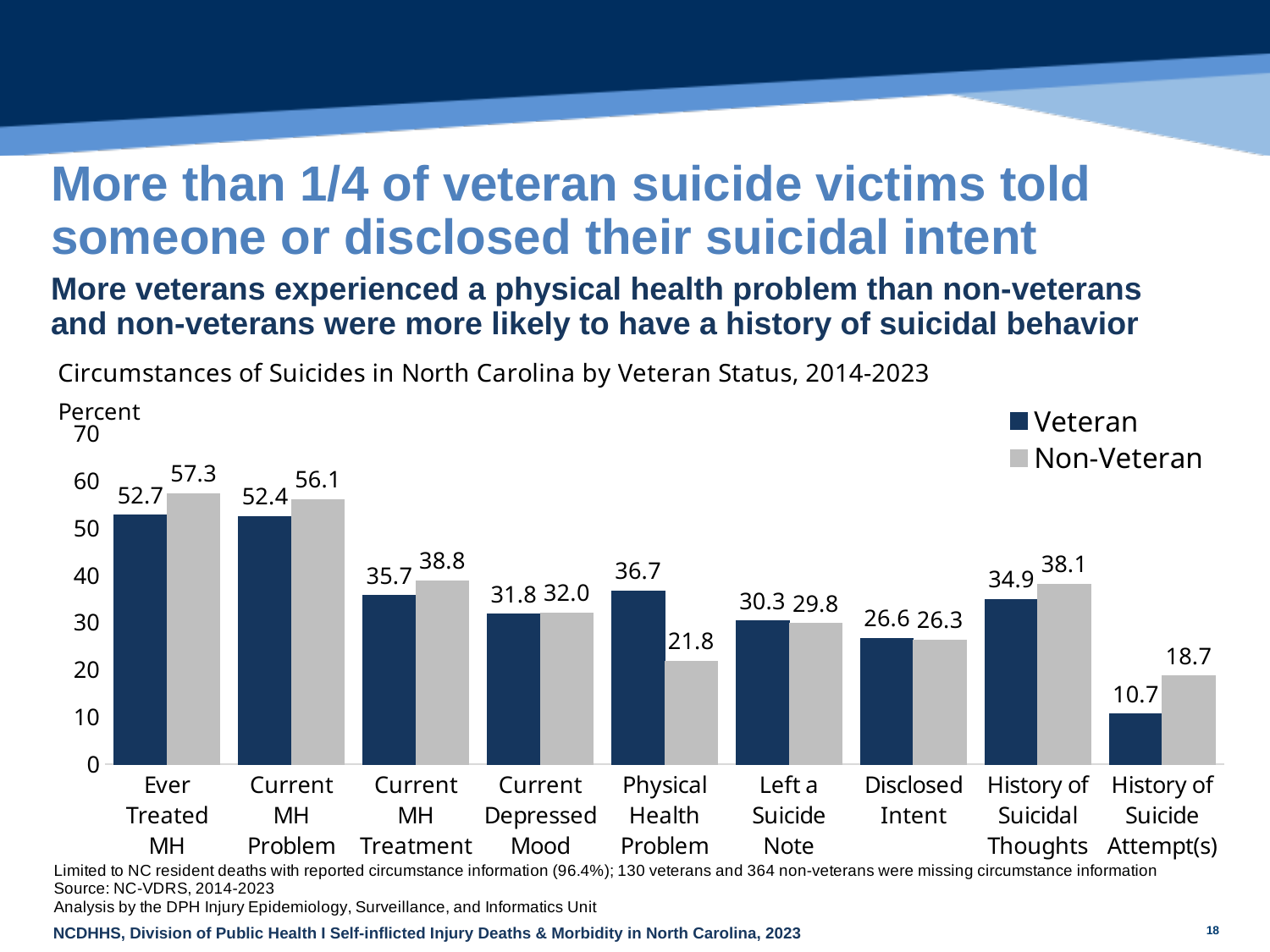
What is the Veteran value for Disclosed Intent? 26.6 What is the Veteran value for Physical Health Problem? 36.7 What is the difference between the Veteran and Non-Veteran values for Physical Health Problem? 14.9 What is the difference between the Non-Veteran and Veteran values for History of Suicide Attempt(s)? 8.0 What is the title of the chart? Circumstances of Suicides in North Carolina by Veteran Status, 2014-2023 How many series does the legend list? 2 Which category has the highest Non-Veteran value? Ever Treated MH Which category has the lowest Veteran value? History of Suicide Attempt(s) What is the Non-Veteran value for History of Suicide Attempt(s)? 18.7 How many categories are shown on the x axis? 9 What kind of chart is shown on the slide? Bar chart For Current MH Treatment, which is larger: the Veteran value or the Non-Veteran value? Non-Veteran